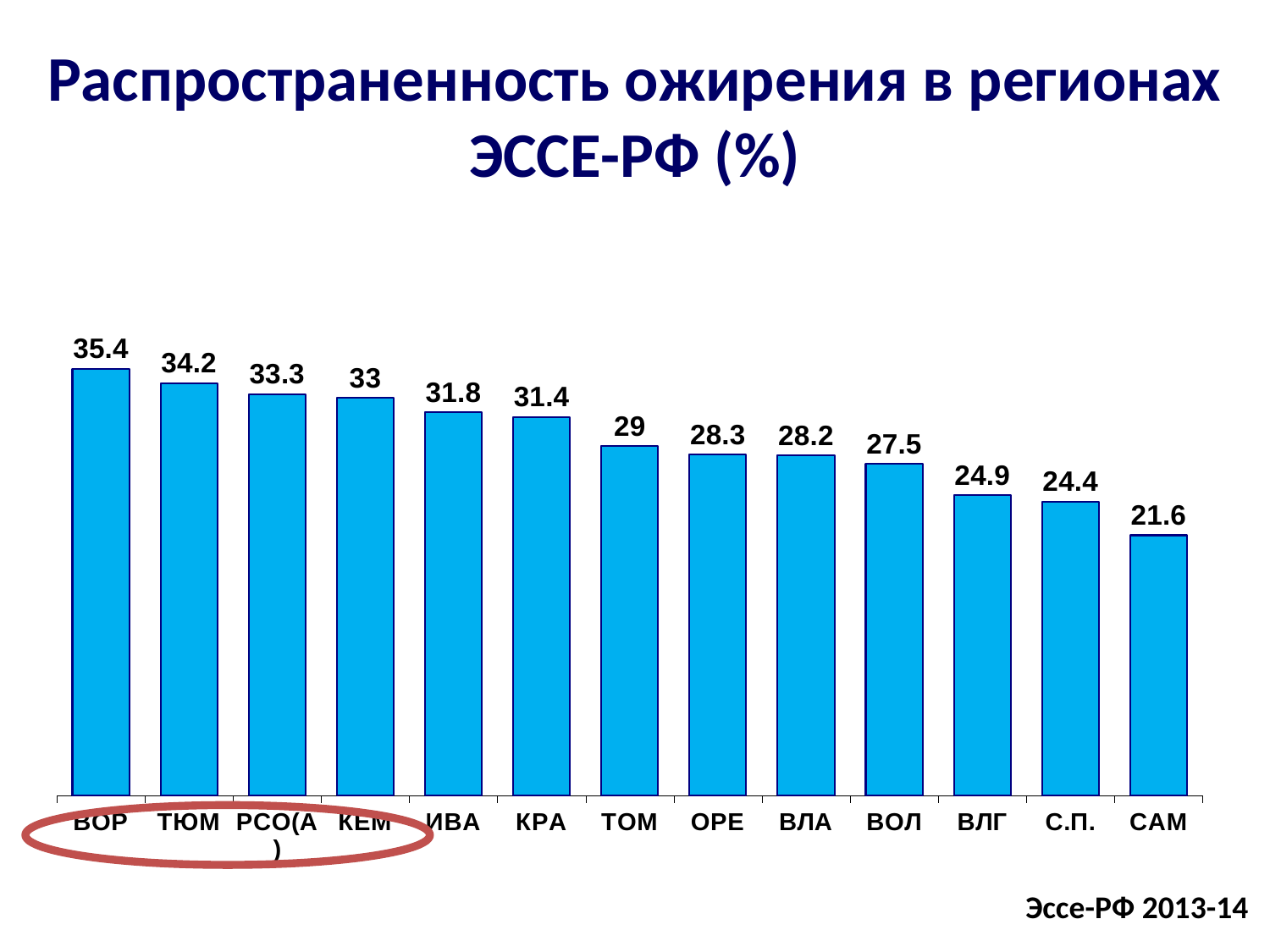
What is the difference between the values for ТЮМ and ТОМ? 5.2 What is the value shown for ВЛГ? 24.9 Which has a larger value, ИВА or ВОЛ? ИВА What kind of chart is shown on the slide? Bar chart What is the value shown for КЕМ? 33 What is the difference between the values for ВОР and САМ? 13.8 How many regions are shown in the chart? 13 What is the obesity prevalence value for ВОР? 35.4 Do the values rise or fall from left to right along the x axis? Fall Which region has the lowest obesity prevalence? САМ Which region has the highest obesity prevalence? ВОР What is the title of the chart on the slide? Распространенность ожирения в регионах ЭССЕ-РФ (%)